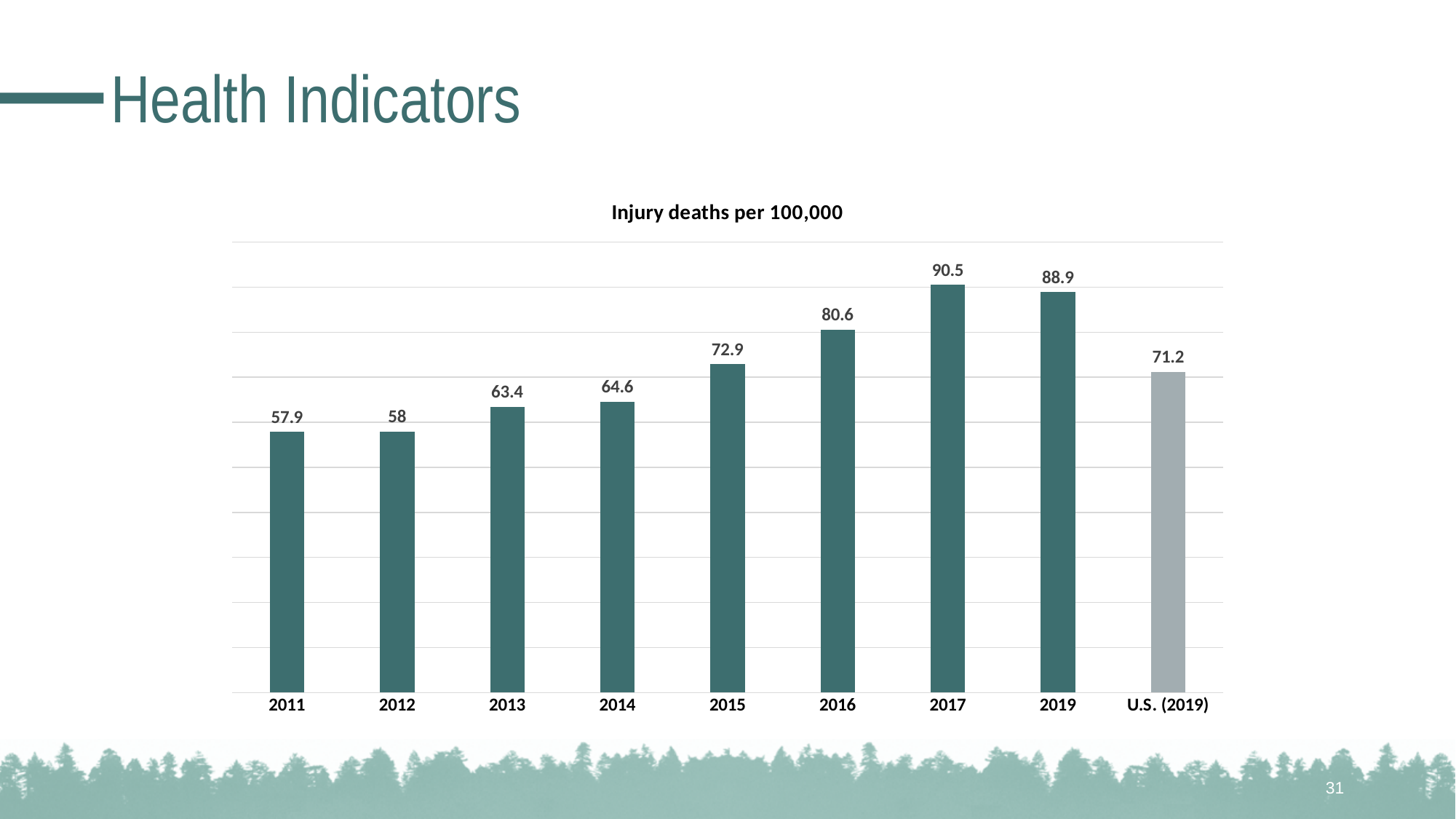
What is the value for 2017 in the Injury deaths per 100,000 chart? 90.5 How many bars are shown in the Injury deaths per 100,000 chart? 9 What is the title of the chart on the slide? Injury deaths per 100,000 Do the values generally rise or fall from 2011 to 2017 in the Injury deaths per 100,000 chart? Rise Which bar in the Injury deaths per 100,000 chart is coloured grey rather than teal? U.S. (2019) Which category has the lowest value in the Injury deaths per 100,000 chart? 2011 Which is larger in the Injury deaths per 100,000 chart, the value for 2015 or the value for U.S. (2019)? 2015 Which category has the highest value in the Injury deaths per 100,000 chart? 2017 What is the difference between the 2019 value and the U.S. (2019) value in the Injury deaths per 100,000 chart? 17.7 What kind of chart is shown on the slide? Bar chart What is the value for 2012 in the Injury deaths per 100,000 chart? 58 What is the value for U.S. (2019) in the Injury deaths per 100,000 chart? 71.2